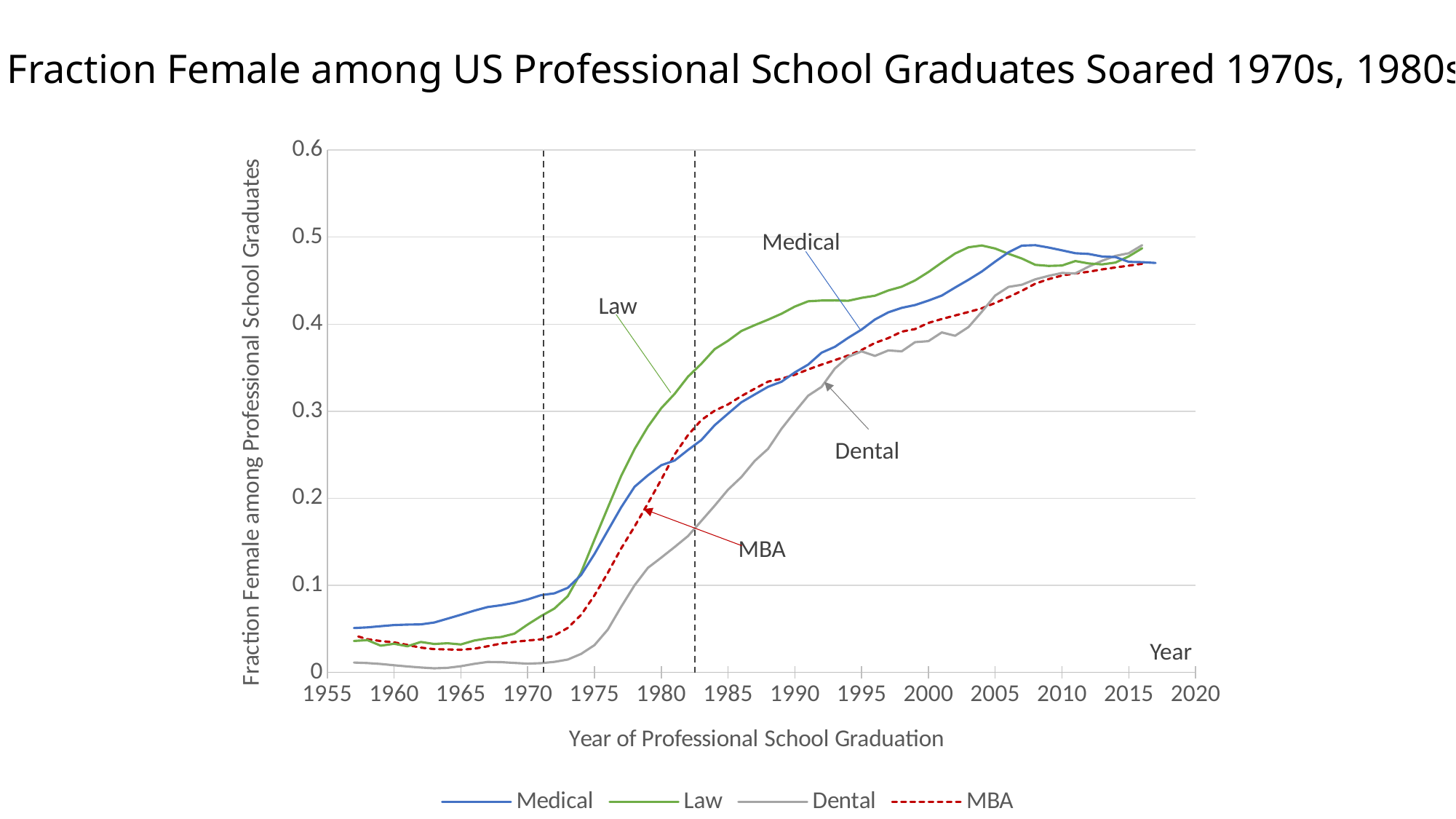
Is the value for Law in 1985 greater or less than 0.3? greater In 1985, which series has the higher value, Law or Dental? Law Which series is drawn with a dashed red line? MBA Is the value for Medical in 1970 greater or less than 0.1? less Does the Dental series rise or fall between 1975 and 2015? rise Which series has the lowest value in 1980? Dental What is the label of the x axis? Year of Professional School Graduation What kind of chart is shown on the slide? line chart Is the value for MBA in 1965 greater or less than 0.1? less In 1990, which series has the higher value, Law or MBA? Law How many series does the legend list? 4